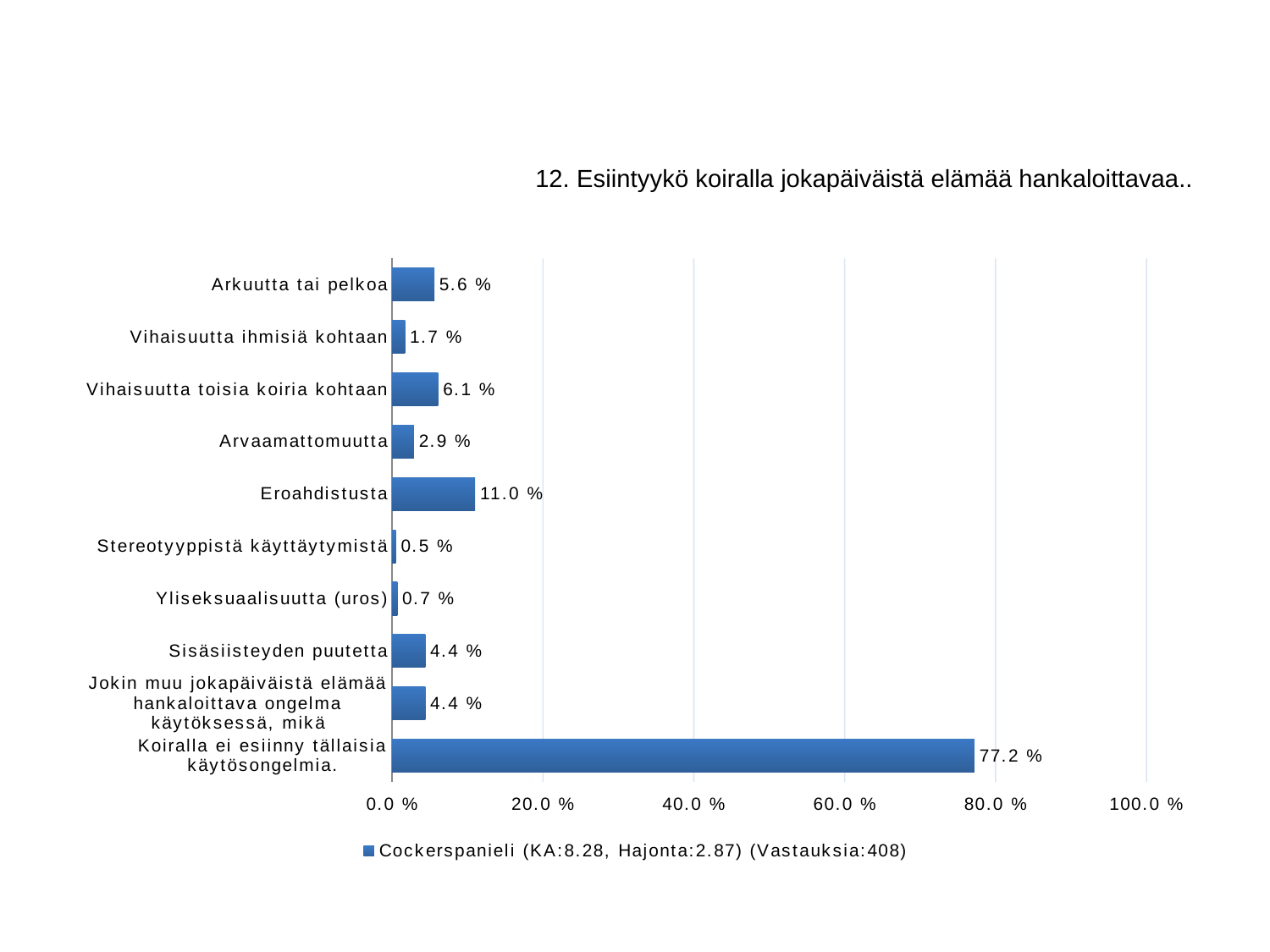
Which category has the lowest value? Stereotyyppistä käyttäytymistä How many categories are shown on the chart? 10 What is the value for Eroahdistusta? 11.0 % How many responses (Vastauksia) does the legend entry report? 408 Is the value for Koiralla ei esiinny tällaisia käytösongelmia greater or less than 60.0 %? greater Which is larger, the value for Arvaamattomuutta or the value for Vihaisuutta ihmisiä kohtaan? Arvaamattomuutta What kind of chart is shown on the slide? bar chart What is the difference between the values for Eroahdistusta and Arkuutta tai pelkoa? 5.4 % What is the value for Vihaisuutta toisia koiria kohtaan? 6.1 % What is the value for Koiralla ei esiinny tällaisia käytösongelmia? 77.2 % Which category has the highest value? Koiralla ei esiinny tällaisia käytösongelmia. How many series does the legend list? 1